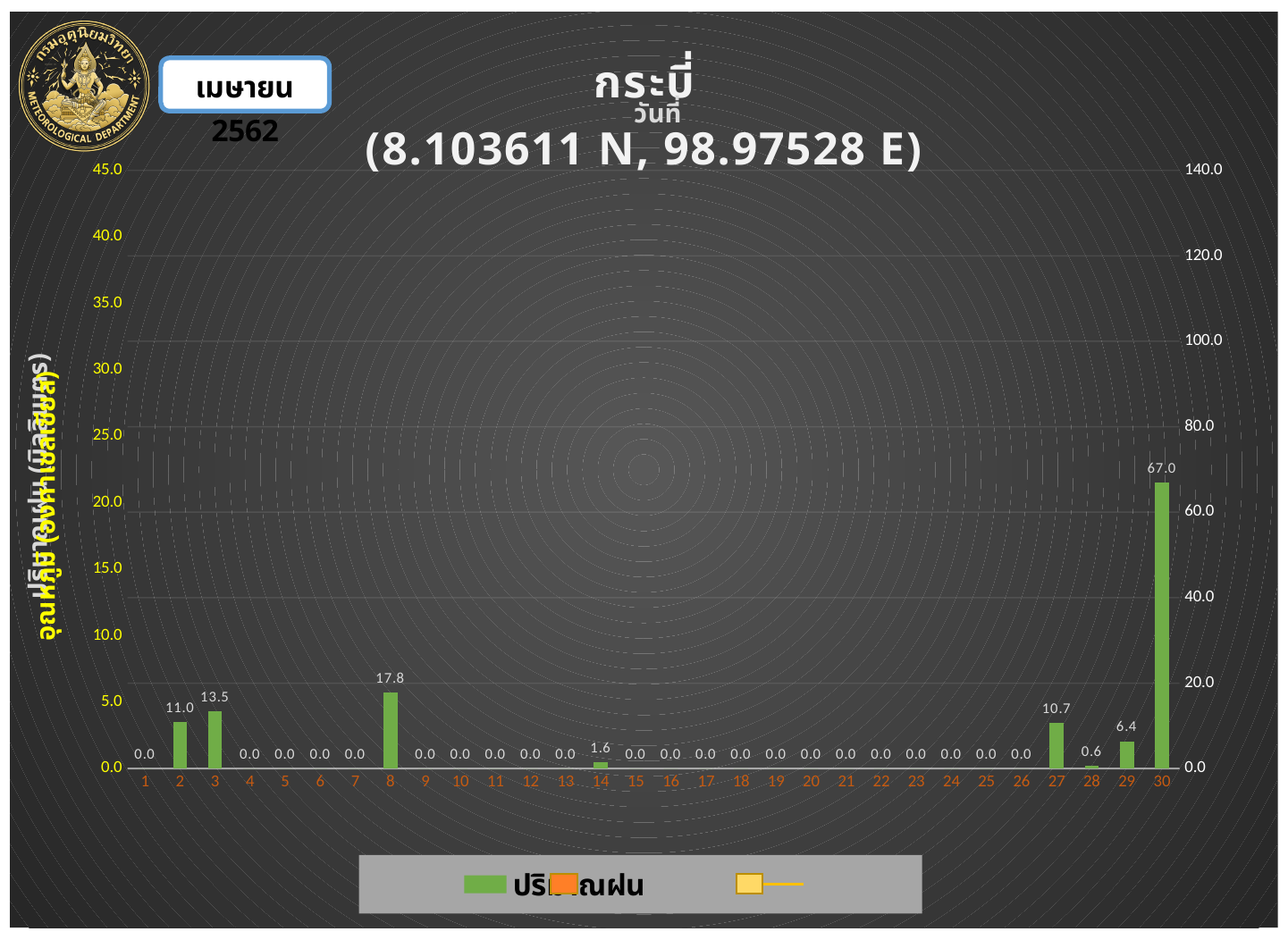
What is the rainfall value for day 8? 17.8 What is the difference between the rainfall values for day 3 and day 2? 2.5 What is the rainfall value for day 3? 13.5 What is the rainfall value for day 27? 10.7 How many days are shown on the x axis? 30 Which is larger, the rainfall value for day 29 or for day 28? day 29 What is the rainfall value for day 14? 1.6 What is the difference between the rainfall values for day 30 and day 8? 49.2 What kind of chart is shown on the slide? bar chart What is the rainfall value for day 30? 67.0 Is the value for day 30 greater or less than 60.0 on the right-hand axis? greater Which day has the highest rainfall value? 30